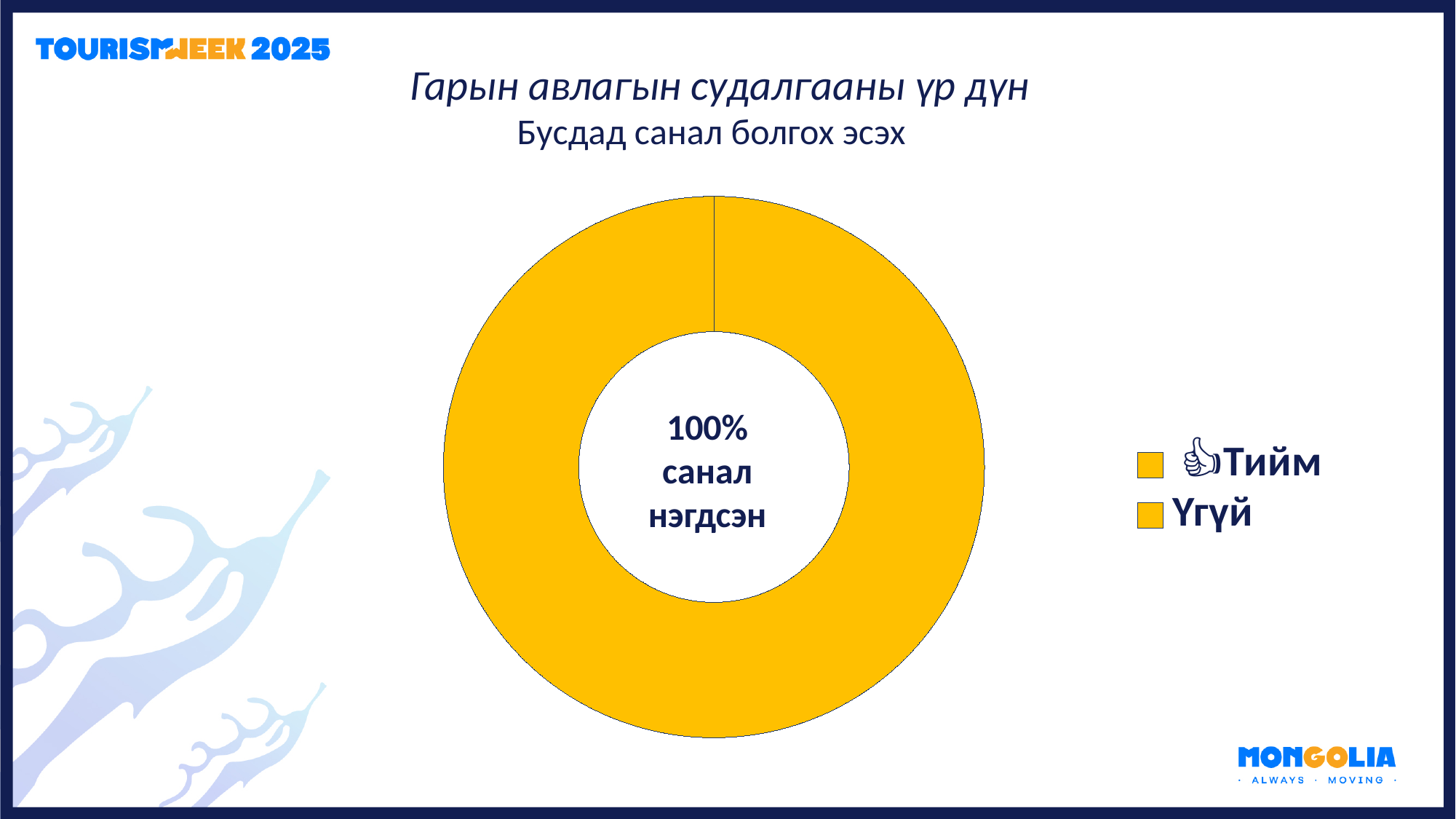
What text is printed in the centre of the doughnut chart? 100% санал нэгдсэн How many entries does the chart legend list? 2 How many visible slices does the doughnut chart have? 1 What share of the doughnut chart does the single visible slice take up? 100% What is the subtitle of the chart shown on the slide? Бусдад санал болгох эсэх What are the two legend entries of the chart? Тийм, Үгүй What percentage is printed in the centre of the doughnut chart? 100% What kind of chart is shown on the slide? doughnut chart